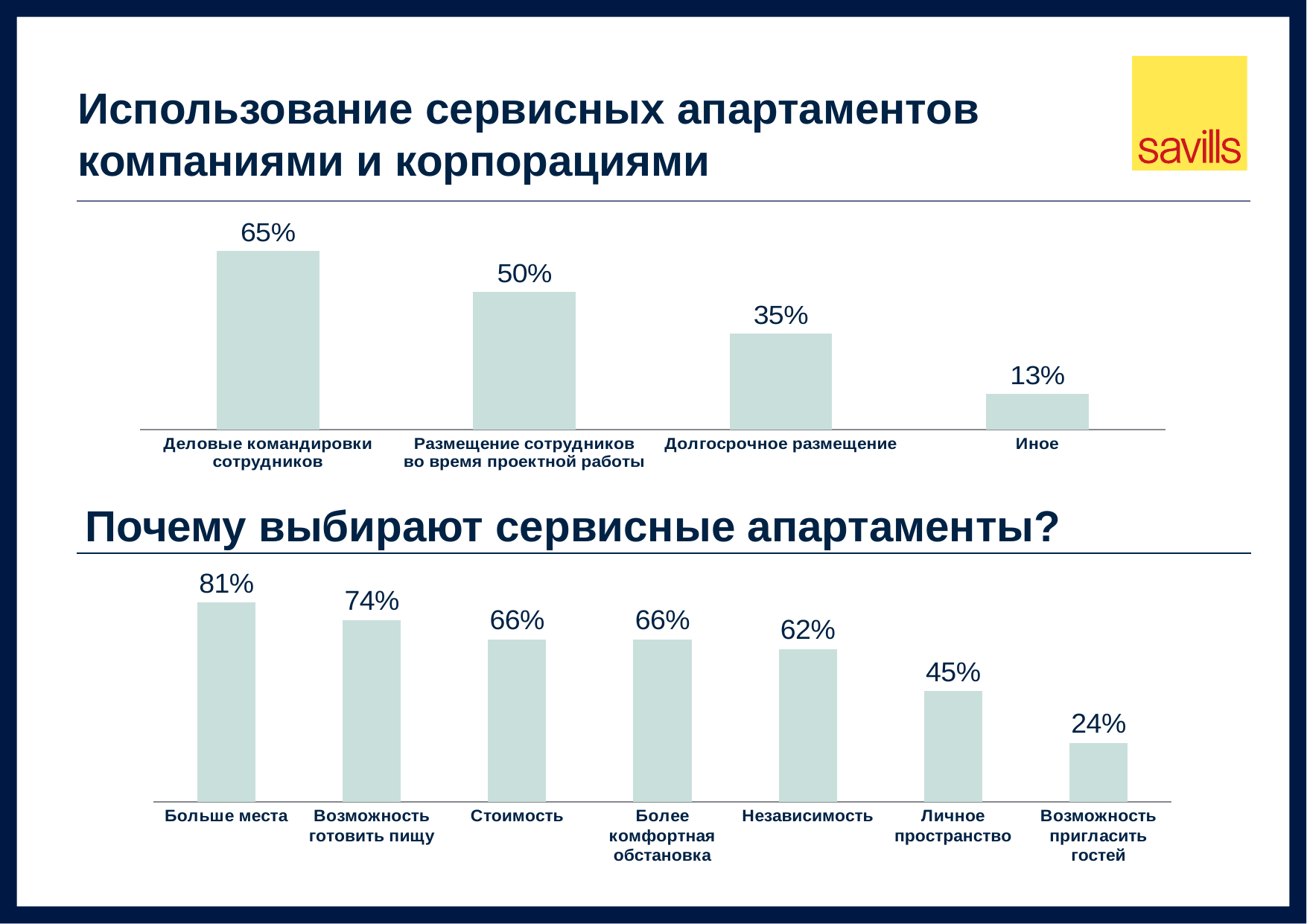
In the top chart (Использование сервисных апартаментов компаниями и корпорациями), what is the value for Деловые командировки сотрудников? 65% What type of chart is the bottom chart? Bar chart In the bottom chart (Почему выбирают сервисные апартаменты?), what is the value for Независимость? 62% In the bottom chart, which category has the lowest value? Возможность пригласить гостей In the top chart, what is the difference between Деловые командировки сотрудников and Размещение сотрудников во время проектной работы? 15% In the bottom chart, which is larger: Возможность готовить пищу or Личное пространство? Возможность готовить пищу In the bottom chart, which category has the highest value? Больше места In the bottom chart, what is the difference between Больше места and Возможность пригласить гостей? 57% In the top chart, what is the value for Долгосрочное размещение? 35% In the top chart, how many categories are shown? 4 In the bottom chart, how many categories are shown? 7 In the top chart, which category has the lowest value? Иное